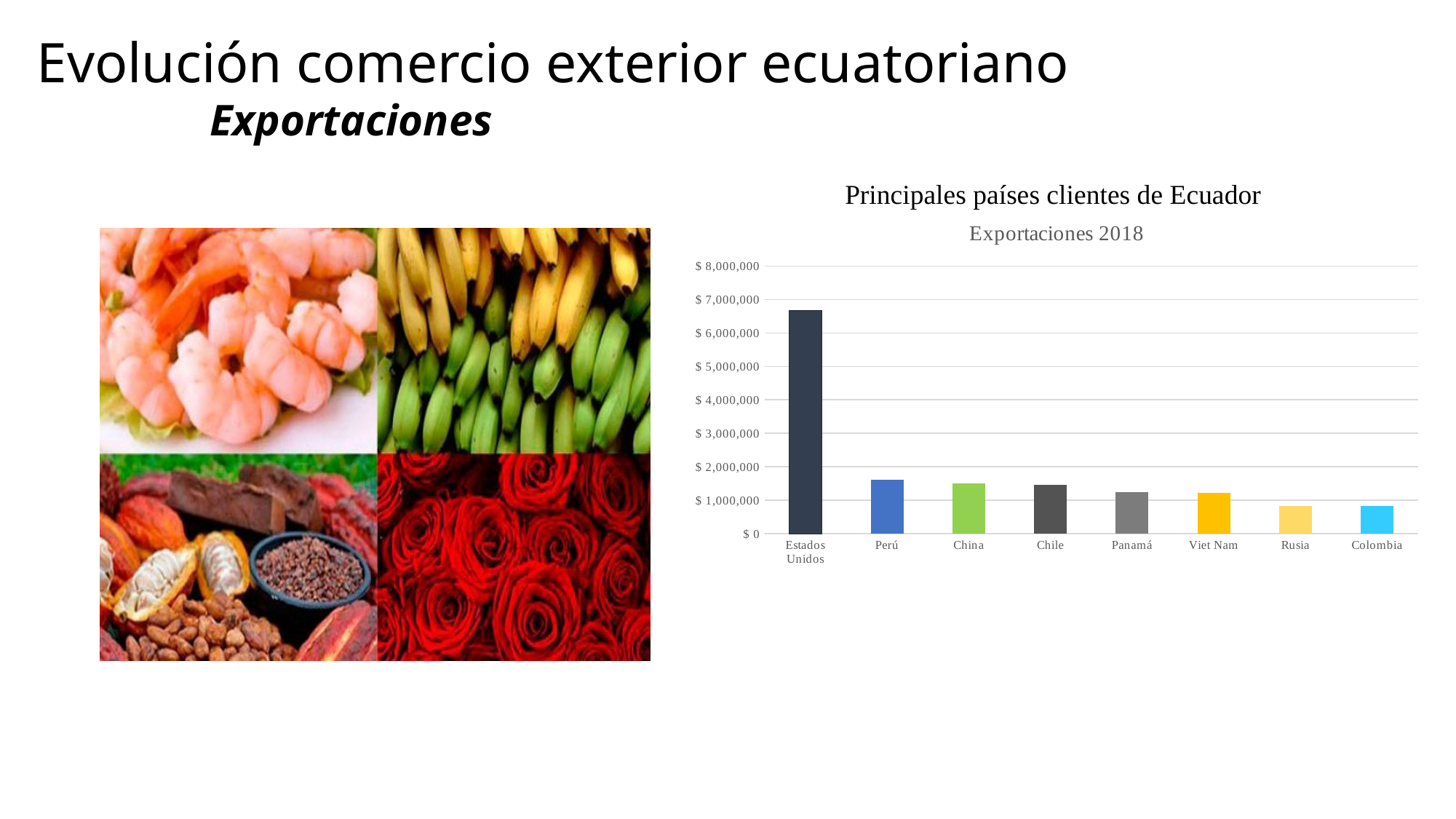
Is the value for Rusia greater or less than $ 1,000,000? less Which is larger, the value for Estados Unidos or the value for Perú? Estados Unidos How many countries are shown on the x axis of the chart? 8 What is the title of the chart? Principales países clientes de Ecuador What kind of chart is shown on the slide? bar chart Is the value for Perú greater or less than $ 2,000,000? less Is the value for China greater or less than $ 1,000,000? greater Do the bar values generally rise or fall from left to right along the x axis? fall Which country has the highest export value in the chart? Estados Unidos What subtitle appears below the chart title? Exportaciones 2018